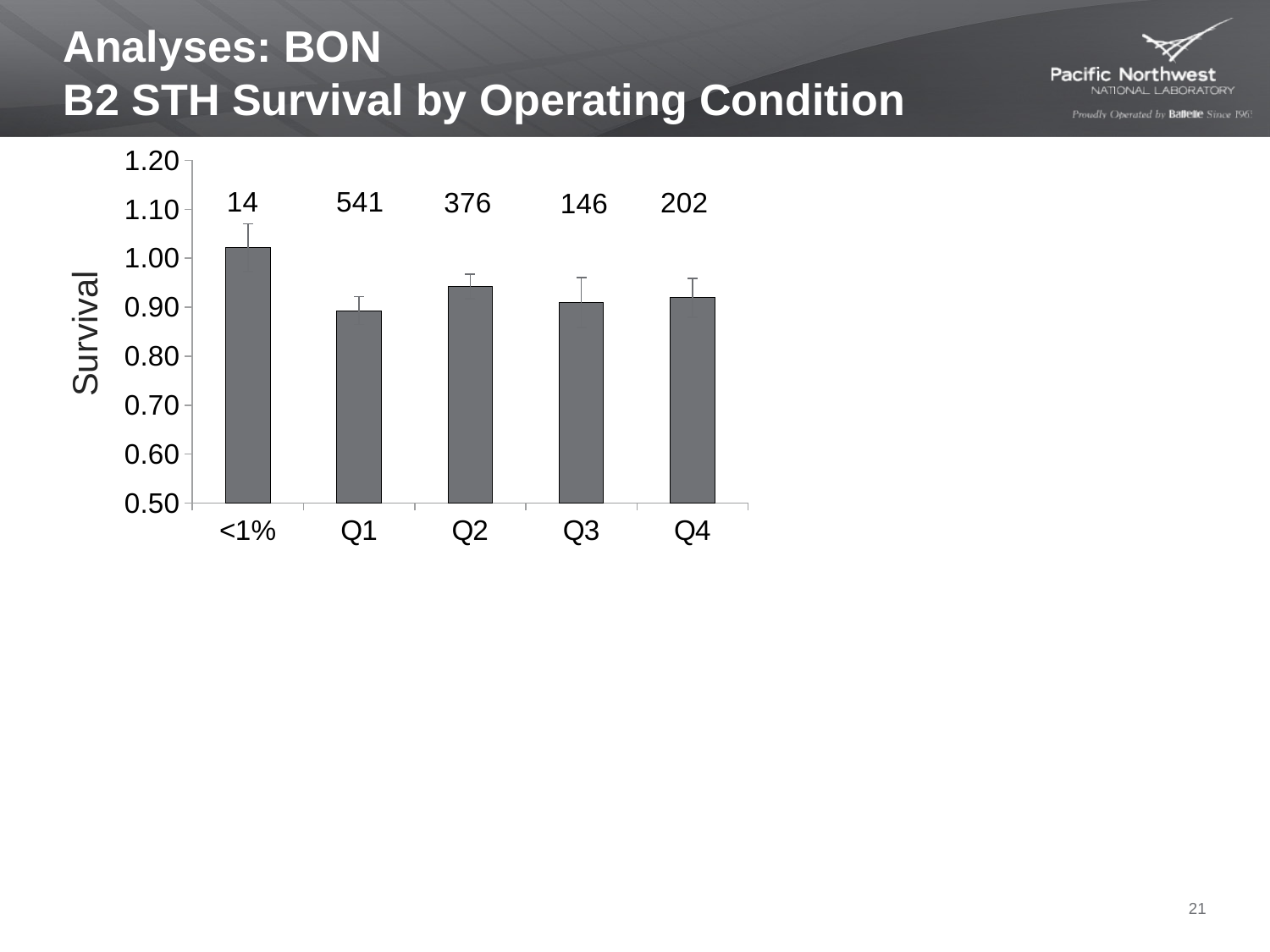
Is the survival value for Q3 greater or less than 1.00? less Is the survival value for Q4 greater or less than 0.80? greater What number is printed above the Q1 bar? 541 Is the survival value for <1% greater or less than 0.90? greater Which category has the highest survival value in the chart? <1% What is the label of the y axis of the chart? Survival What kind of chart is shown on the slide? bar chart Which has the larger survival value, <1% or Q1? <1% Which has the larger survival value, Q2 or Q1? Q2 How many categories are shown on the x axis of the chart? 5 What number is printed above the <1% bar? 14